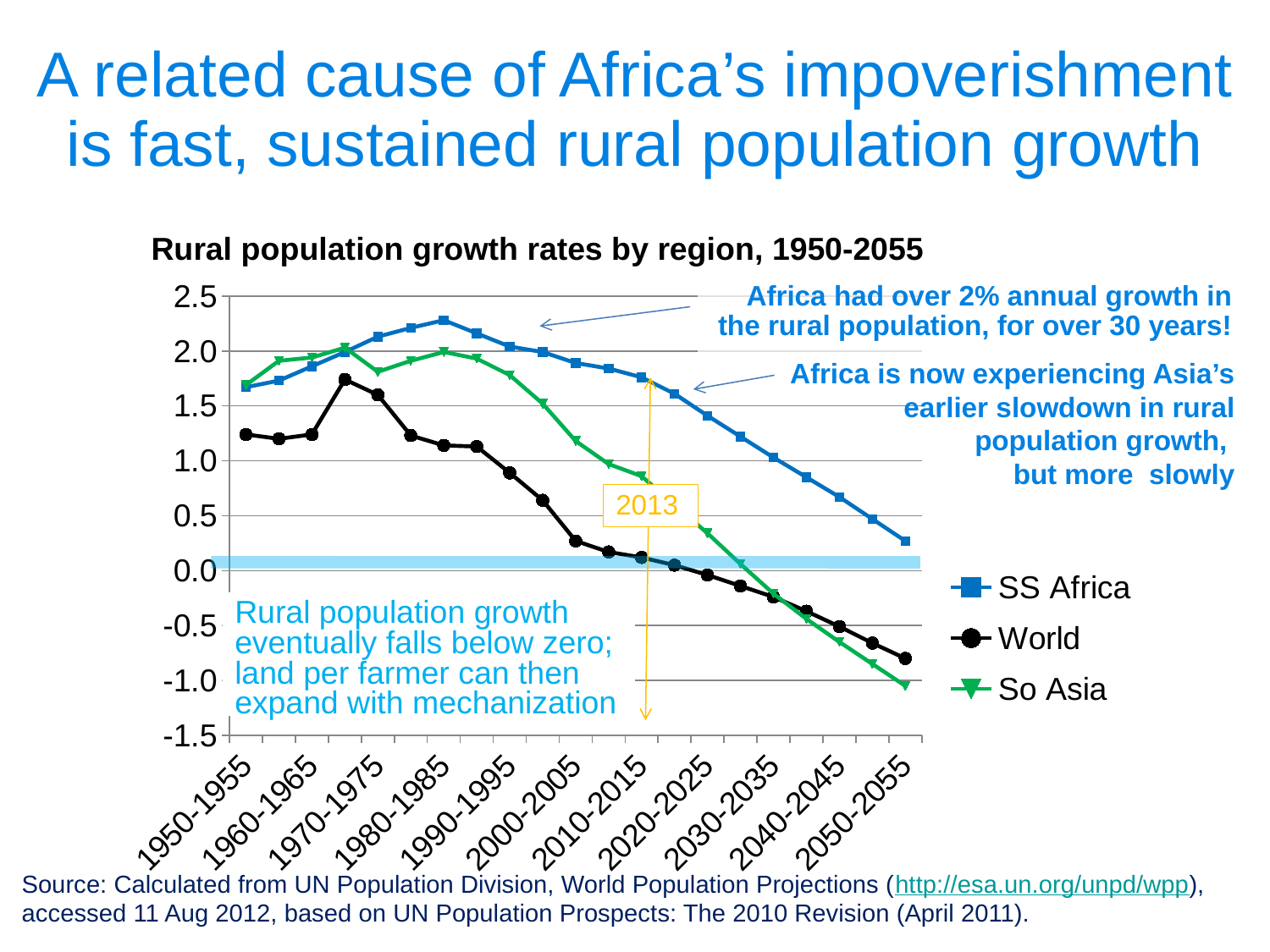
Is the value for So Asia in 2020-2025 greater or less than 0.5? less Which series has the highest value in 2050-2055? SS Africa Does the World series generally rise or fall from 1970-1975 to 2050-2055? fall In 1990-1995, which is larger, the value for So Asia or the value for World? So Asia What kind of chart is shown on the slide? line chart Is the value for SS Africa in 1950-1955 greater or less than 1.5? greater Is the value for World in 1950-1955 greater or less than 1.0? greater How many series does the legend list? 3 What are the three series named in the legend? SS Africa, World, So Asia What is the title of the chart? Rural population growth rates by region, 1950-2055